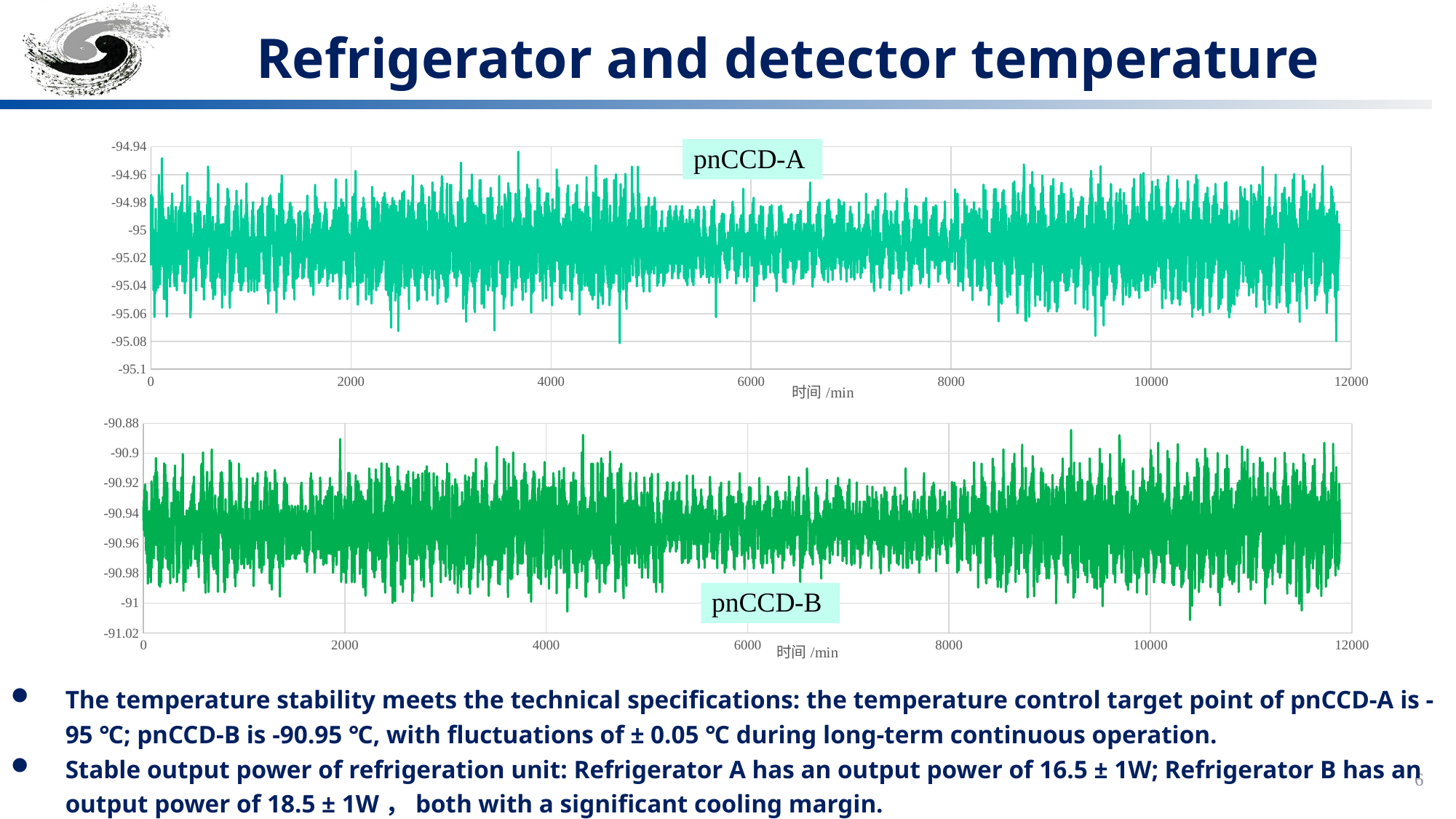
In the pnCCD-A chart, does the temperature show a clear rising trend, a clear falling trend, or stay roughly constant over time? roughly constant Which detector shows higher (warmer) temperatures, pnCCD-A or pnCCD-B? pnCCD-B What is the x-axis label on the pnCCD-A chart? 时间 /min What is the lowest y-axis tick value shown on the pnCCD-B chart? -91.02 In the pnCCD-B chart, are the plotted temperature values greater or less than -91.02? greater In the pnCCD-B chart, are the plotted temperature values greater or less than -90.88? less In the pnCCD-B chart, does the temperature show a clear rising trend, a clear falling trend, or stay roughly constant over time? roughly constant In the pnCCD-A chart, are the plotted temperature values greater or less than -95.1? greater What kind of chart is the pnCCD-A chart at the top of the slide? line chart How many data series are plotted in the pnCCD-B chart? 1 How many charts are shown on the slide? 2